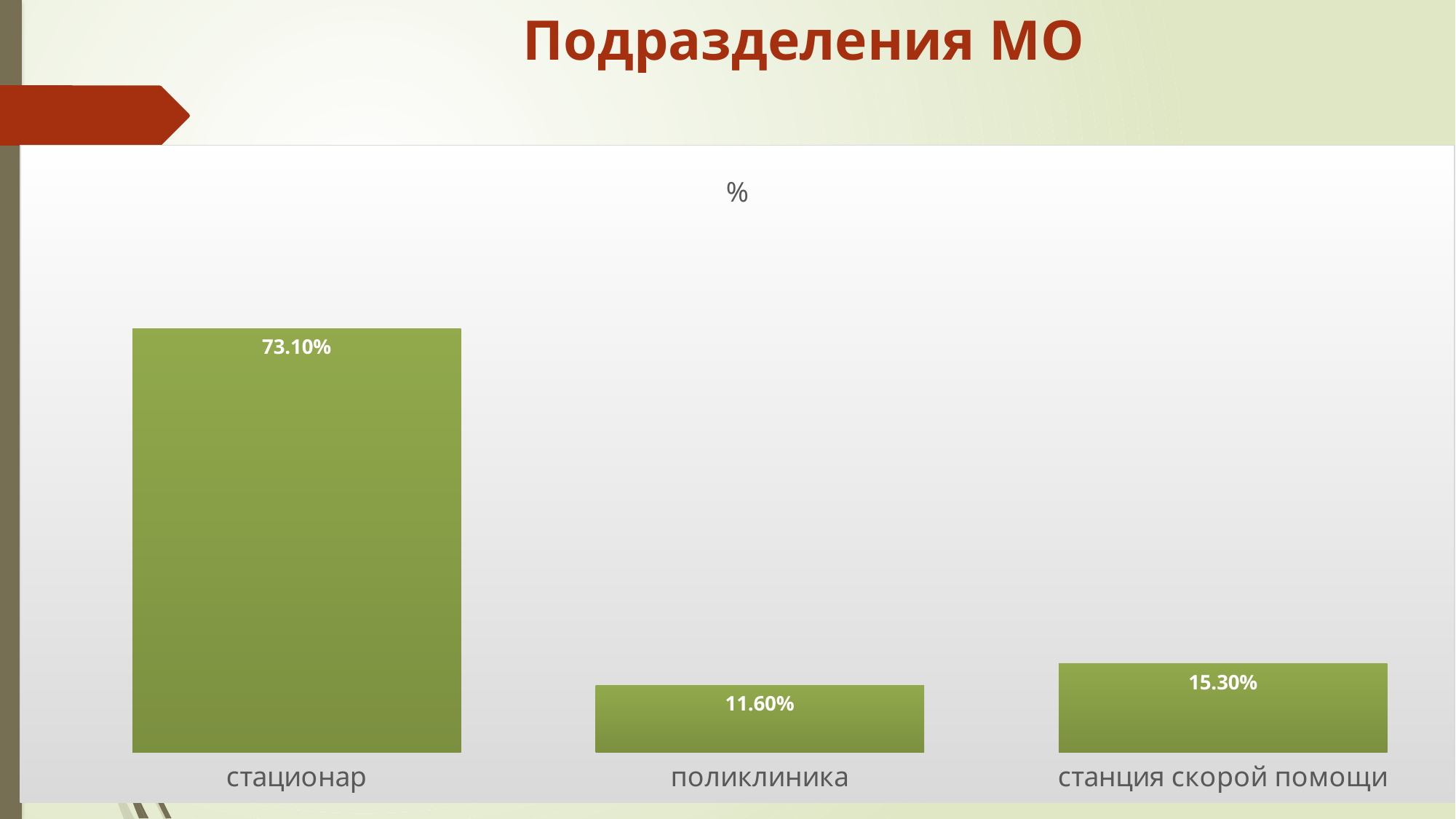
What is the value for стационар? 73.10% What is the difference between the values for станция скорой помощи and поликлиника? 3.70% Which is larger, the value for поликлиника or the value for станция скорой помощи? станция скорой помощи What is the difference between the values for стационар and станция скорой помощи? 57.80% What kind of chart is shown on the slide? bar chart Which category has the highest value? стационар What is the title of the chart? % What is the value for поликлиника? 11.60% What is the value for станция скорой помощи? 15.30% What is the title of the slide? Подразделения МО Which category has the lowest value? поликлиника How many categories are shown in the chart? 3